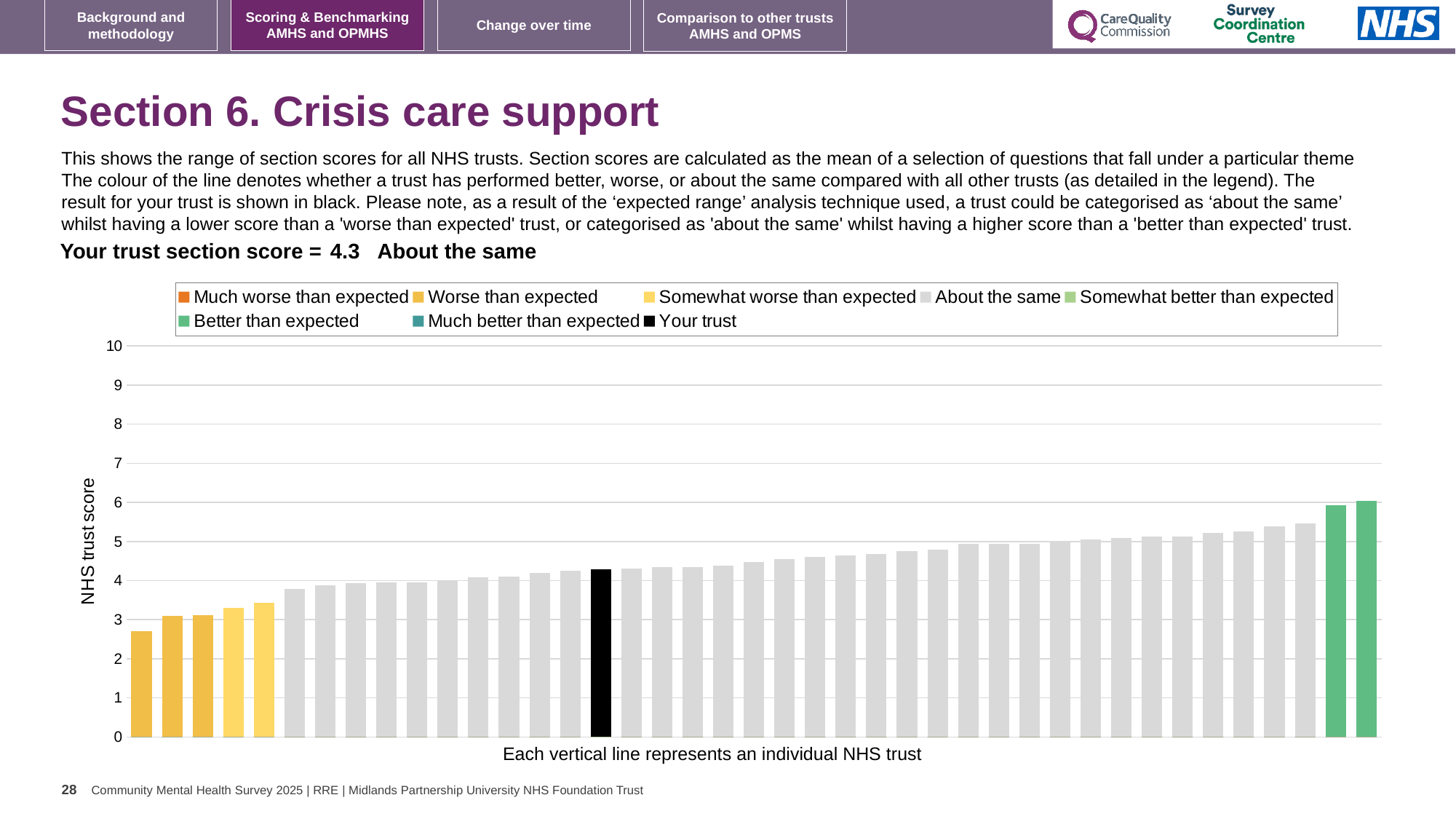
Which category is your trust placed in according to the slide? About the same Which is larger, the leftmost bar or the rightmost bar? the rightmost bar How many entries does the chart legend list? 8 Do the bar values rise or fall from left to right along the x axis? rise How many bars are coloured green ('Better than expected')? 2 What is the label on the vertical axis of the chart? NHS trust score What kind of chart is shown on the slide? bar chart Is the value of the rightmost (highest) bar greater or less than 7? less Is the value of the leftmost (lowest) bar greater or less than 3? less What is the section score for your trust shown on the slide? 4.3 Is the value of the black 'Your trust' bar greater or less than 4? greater